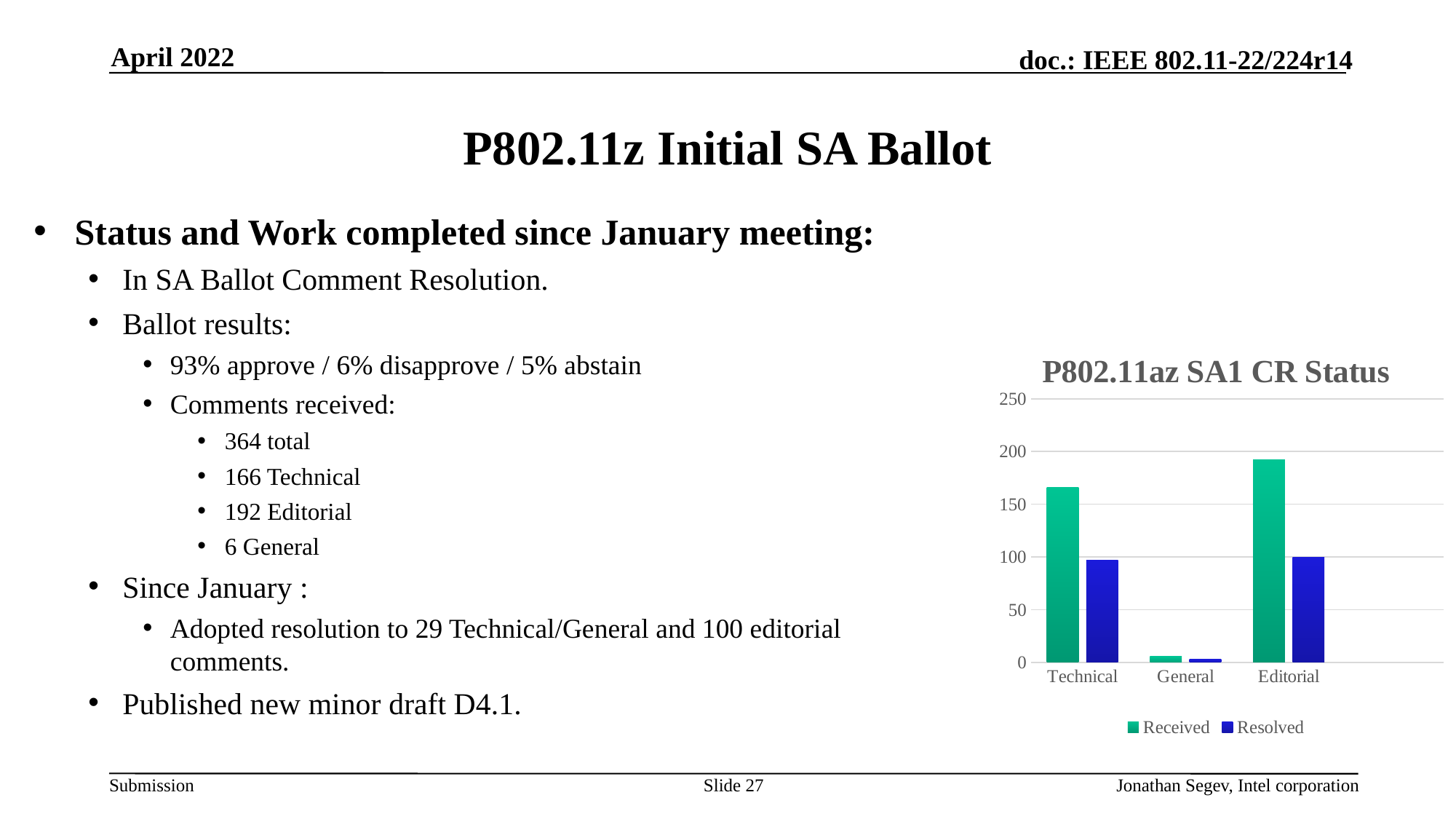
Is the Received value for Technical greater or less than 150? greater Which category has the lowest Resolved value? General Is the Received value for Editorial greater or less than 200? less What is the title of the chart? P802.11az SA1 CR Status For Technical, which is larger: Received or Resolved? Received Which category has the lowest Received value? General What kind of chart is shown on the slide? bar chart Which category has the highest Received value? Editorial Which series is shown in green in the chart? Received How many series does the chart legend list? 2 How many categories are shown on the x axis of the chart? 3